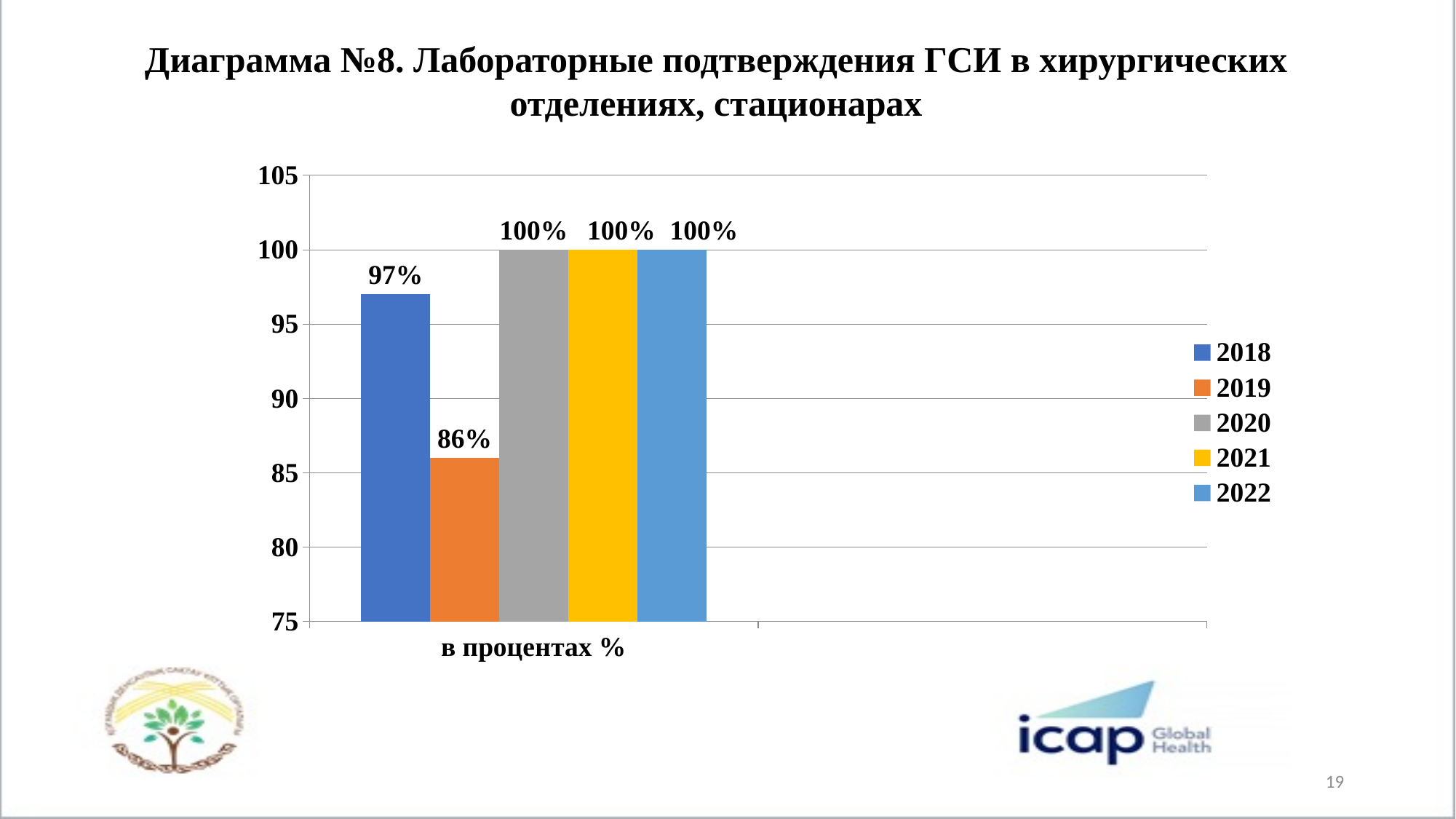
How many series does the legend list? 5 What is the value for 2018? 97% What colour is the bar for 2021? yellow Which year has the lowest value? 2019 Which is larger, the value for 2018 or the value for 2019? 2018 What is the value for 2021? 100% What is the difference between the values for 2020 and 2019? 14% What kind of chart is shown on the slide? bar chart What is the label shown under the bars on the x axis? в процентах % What is the difference between the values for 2018 and 2019? 11% Is the value for 2019 greater or less than 90? less What is the value for 2019? 86%